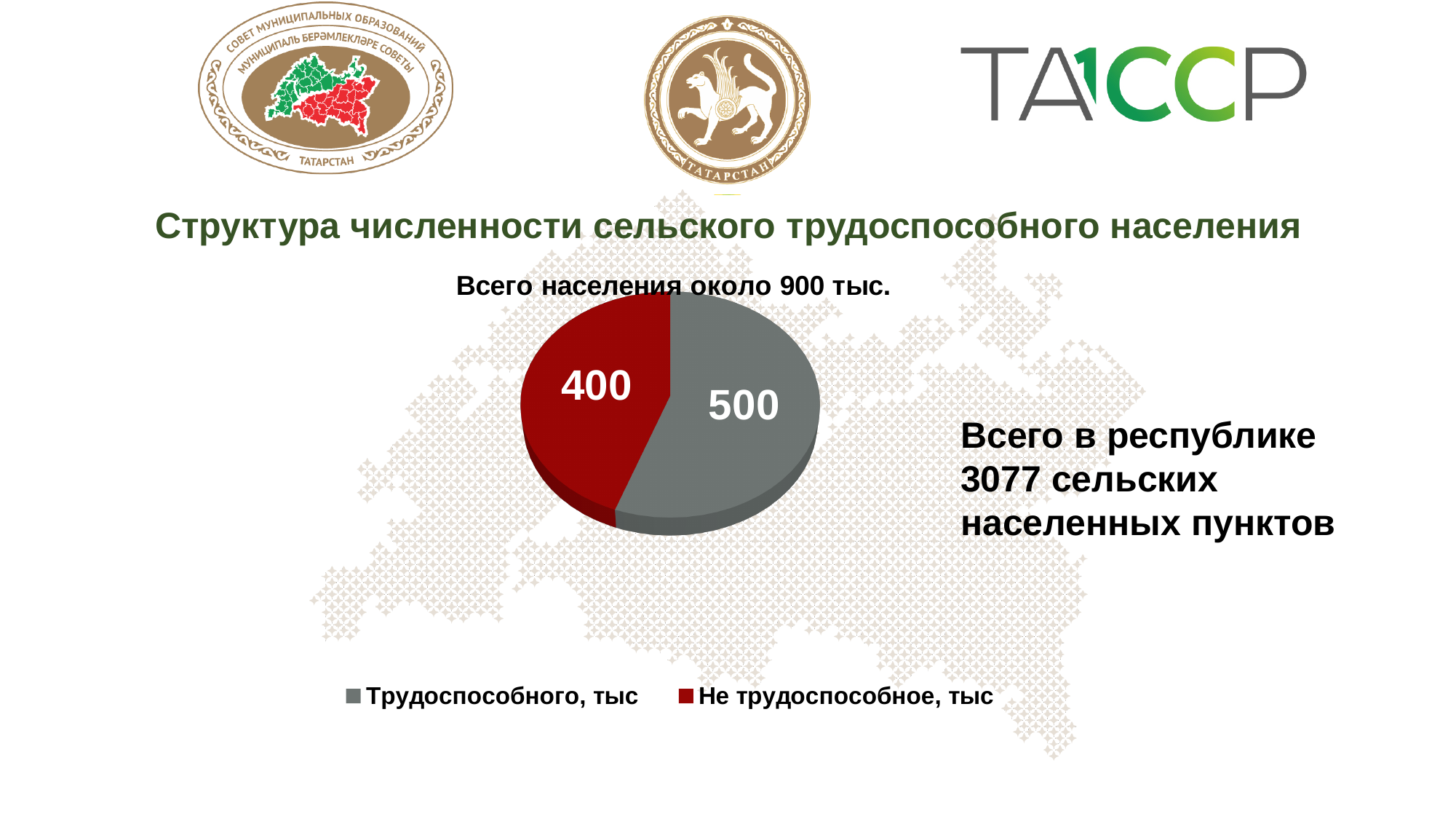
What colour is the Не трудоспособное, тыс slice? red What type of chart is shown on the slide? pie chart How many slices does the pie chart have? 2 Which slice is the smallest? Не трудоспособное, тыс What is the value for Не трудоспособное, тыс? 400 Which is larger: Трудоспособного, тыс or Не трудоспособное, тыс? Трудоспособного, тыс What is the difference between the Трудоспособного, тыс and Не трудоспособное, тыс values? 100 What is the total of the two slices in the pie chart? 900 How many entries does the legend list? 2 Which slice is the largest? Трудоспособного, тыс What is the title of the chart? Всего населения около 900 тыс. What is the value for Трудоспособного, тыс? 500